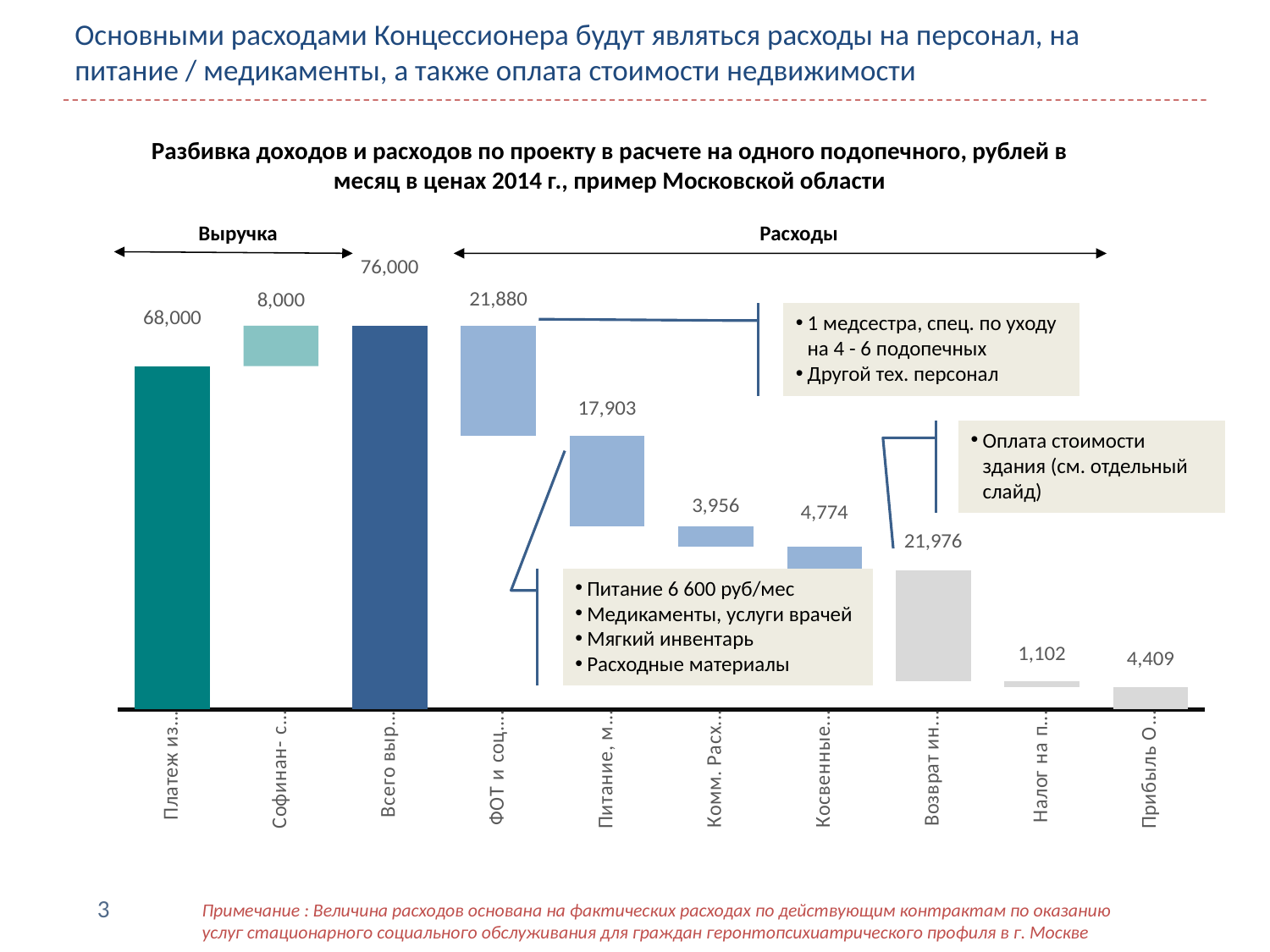
What are the two section headings shown above the chart with arrows? Выручка and Расходы What is the value shown for the bar labelled "Всего выр..."? 76,000 What kind of chart is shown on the slide? bar chart Which is larger, the value for "Питание, м..." or the value for "Косвенные..."? Питание, м... What is the value shown for the bar labelled "Прибыль О..."? 4,409 Which bar has the lowest value on the chart? Налог на п... (1,102) What is the value shown for the bar labelled "Возврат ин..."? 21,976 What is the difference between the values for "Платеж из..." and "Софинан- с..."? 60,000 What is the value shown for the bar labelled "ФОТ и соц..."? 21,880 Which bar has the highest value on the chart? Всего выр... (76,000) What is the difference between the values for "Косвенные..." and "Комм. Расх..."? 818 How many bars are plotted on the chart? 10